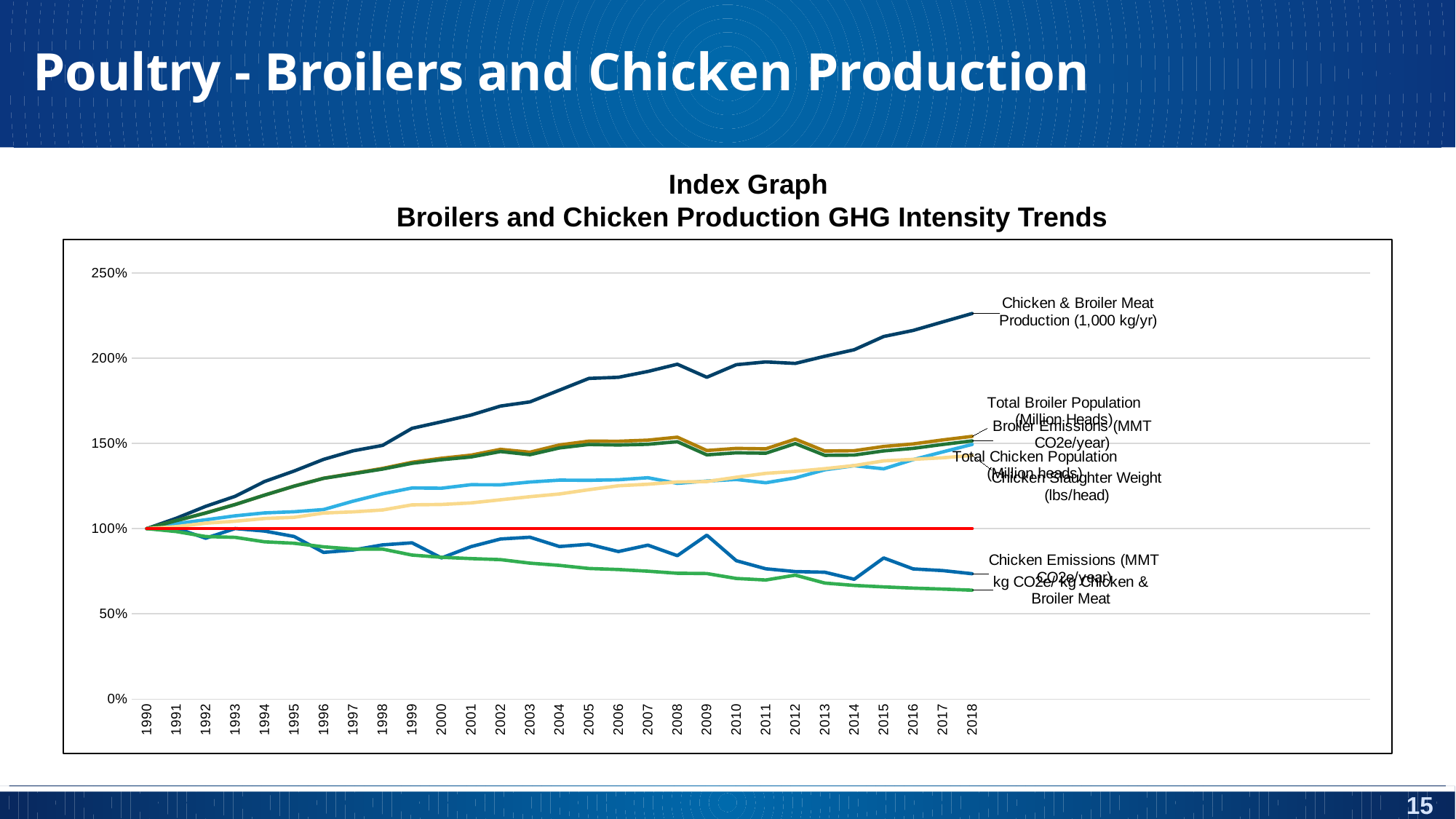
What is the index value of Chicken & Broiler Meat Production (1,000 kg/yr) in 1990? 100% In 2018, which is larger: Chicken & Broiler Meat Production (1,000 kg/yr) or Chicken Emissions (MMT CO2e/year)? Chicken & Broiler Meat Production (1,000 kg/yr) Is the value for Chicken & Broiler Meat Production (1,000 kg/yr) in 2018 greater or less than 200%? greater Is the value for Chicken Emissions (MMT CO2e/year) in 2018 greater or less than 100%? less Does the kg CO2e/kg Chicken & Broiler Meat series rise or fall from 1990 to 2018? Fall How many years are plotted along the x axis? 29 What kind of chart is shown on the slide? Line chart What is the title of the chart? Index Graph Broilers and Chicken Production GHG Intensity Trends Which series has the highest value in 2018? Chicken & Broiler Meat Production (1,000 kg/yr) Which series has the lowest value in 2018? kg CO2e/kg Chicken & Broiler Meat What is the first year shown on the x axis? 1990 Is the value for kg CO2e/kg Chicken & Broiler Meat in 2018 greater or less than 100%? less